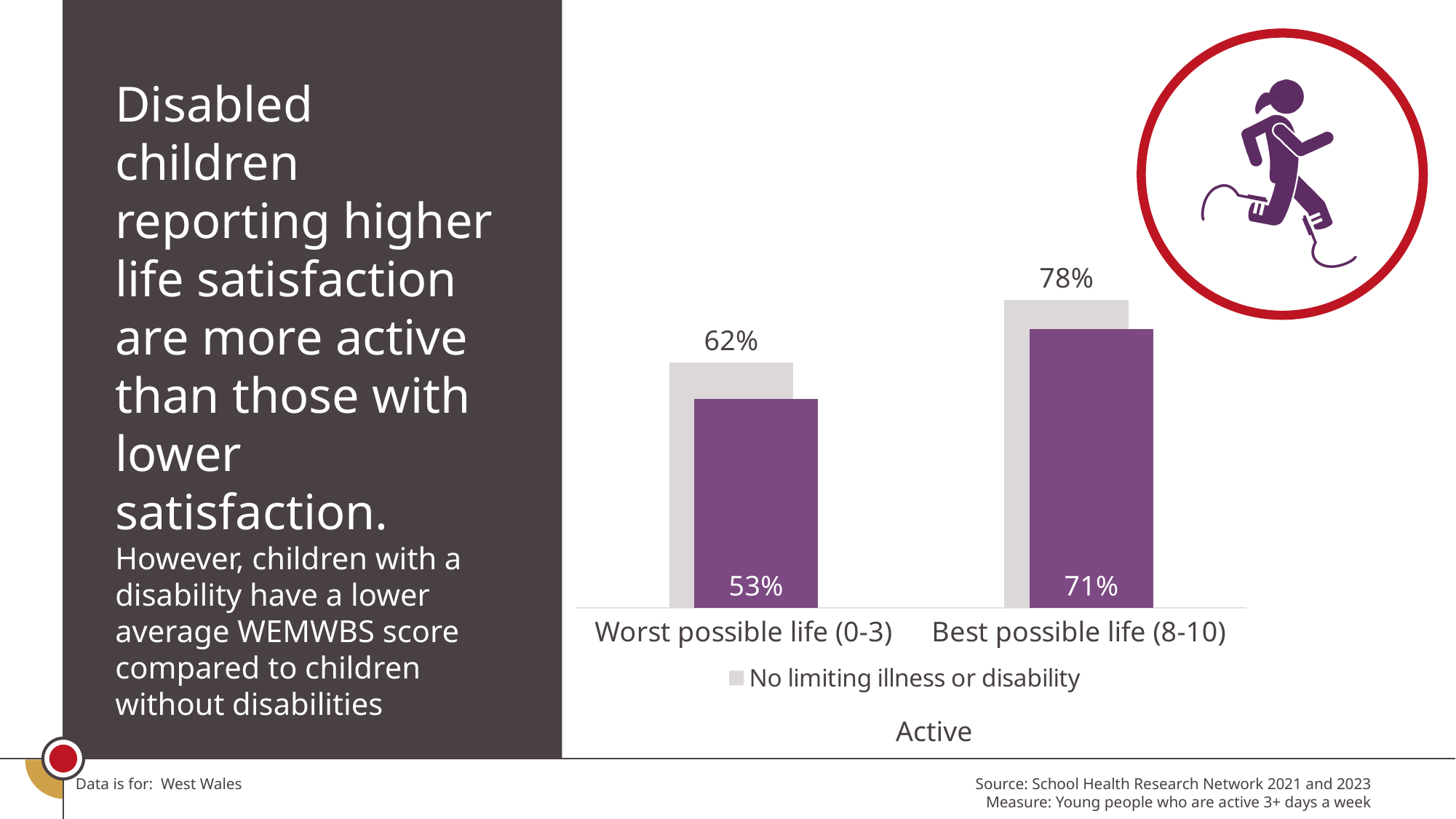
What value is printed on the purple bar for 'Worst possible life (0-3)'? 53% What kind of chart is shown on the slide? Bar chart What value is printed on the purple bar for 'Best possible life (8-10)'? 71% What is the difference between the grey and purple bars for 'Worst possible life (0-3)'? 9% Which category has the higher value for 'No limiting illness or disability'? Best possible life (8-10) How many categories are shown on the x axis? 2 What is the value of the 'No limiting illness or disability' bar for 'Best possible life (8-10)'? 78% What is the value of the 'No limiting illness or disability' bar for 'Worst possible life (0-3)'? 62% Which category has the lowest purple bar? Worst possible life (0-3) For 'Best possible life (8-10)', which is larger: the grey bar or the purple bar? The grey bar (78%) What is the difference between the 'No limiting illness or disability' values for 'Best possible life (8-10)' and 'Worst possible life (0-3)'? 16% What is the title of the chart? Active